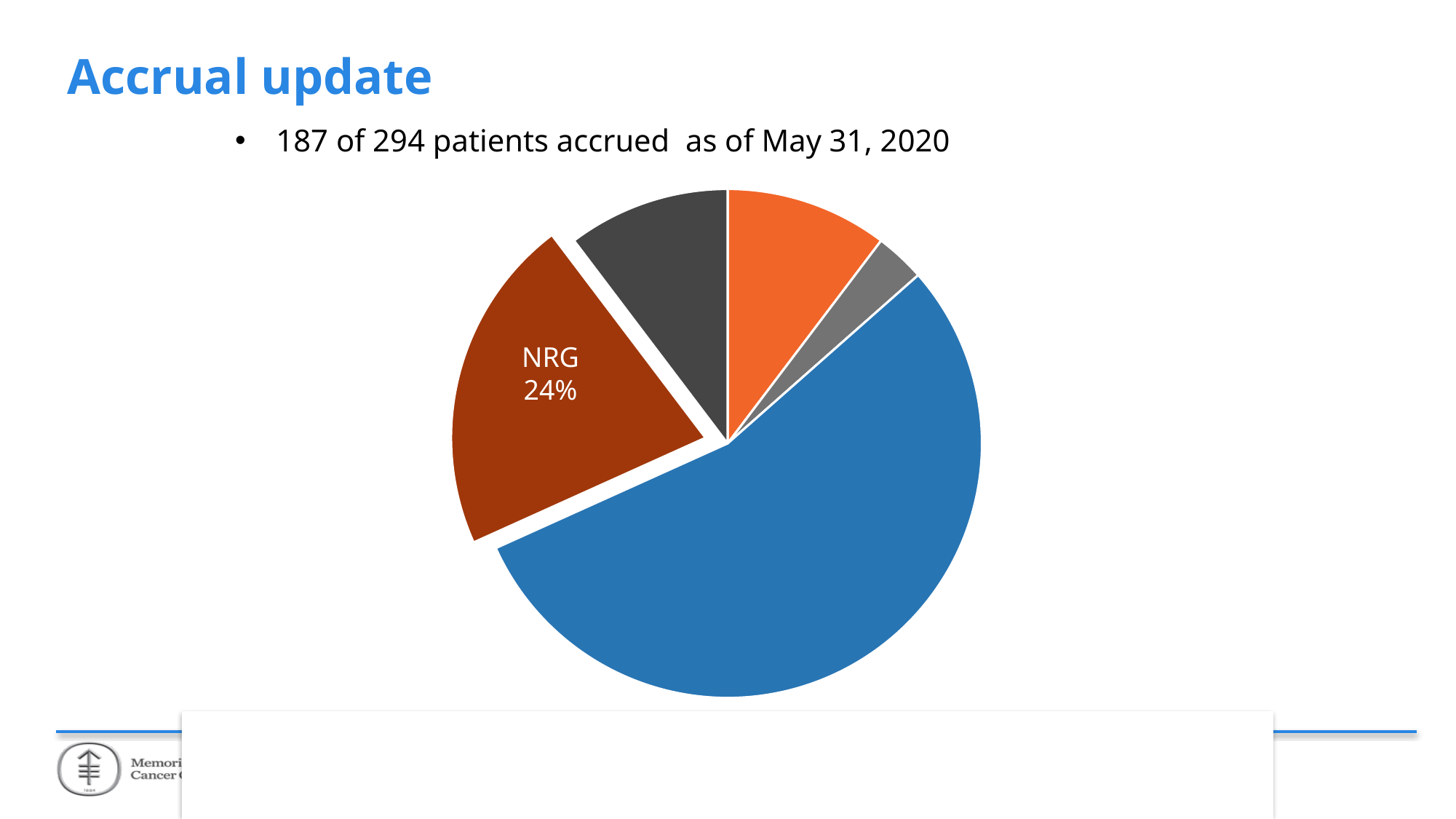
How many slices does the pie chart have? 5 What colour is the largest slice of the pie chart? blue What share of the pie does the NRG slice represent? 24% Is the NRG slice the largest slice in the pie chart? No Is the share of the NRG slice greater or less than 50%? less Which slice is pulled out (exploded) from the rest of the pie? NRG Which slice of the pie chart is labelled with a percentage? NRG Is the blue slice's share of the pie greater or less than 50%? greater Is the NRG slice larger or smaller than the blue slice? smaller Is the NRG slice larger or smaller than the orange slice? larger What kind of chart is shown on the slide? pie chart